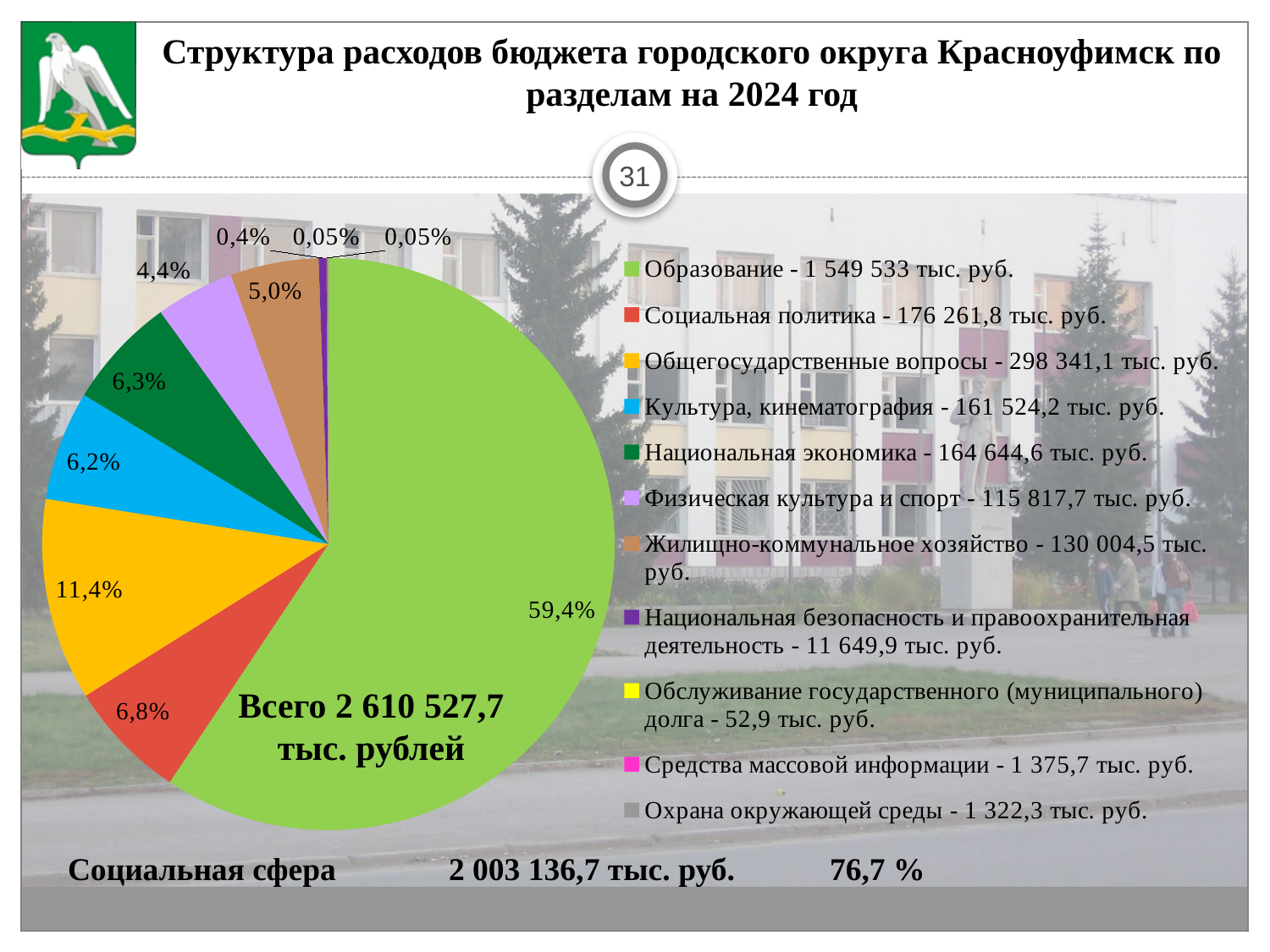
Which category has the largest slice of the pie? Образование What share of the pie does Общегосударственные вопросы take? 11,4% Which slice is larger: Социальная политика or Национальная экономика? Социальная политика What is the value for Жилищно-коммунальное хозяйство according to the legend? 130 004,5 тыс. руб. What is the difference in percentage points between the Образование slice (59,4%) and the Общегосударственные вопросы slice (11,4%)? 48,0% How many categories does the legend of the pie chart list? 11 What share of the pie does Образование take? 59,4% What share of the pie does Физическая культура и спорт take? 4,4% What is the value for Образование according to the legend? 1 549 533 тыс. руб. What kind of chart is shown on the slide? Pie chart What total amount is printed in the centre of the pie chart? Всего 2 610 527,7 тыс. рублей Which category has the smallest value according to the legend? Обслуживание государственного (муниципального) долга